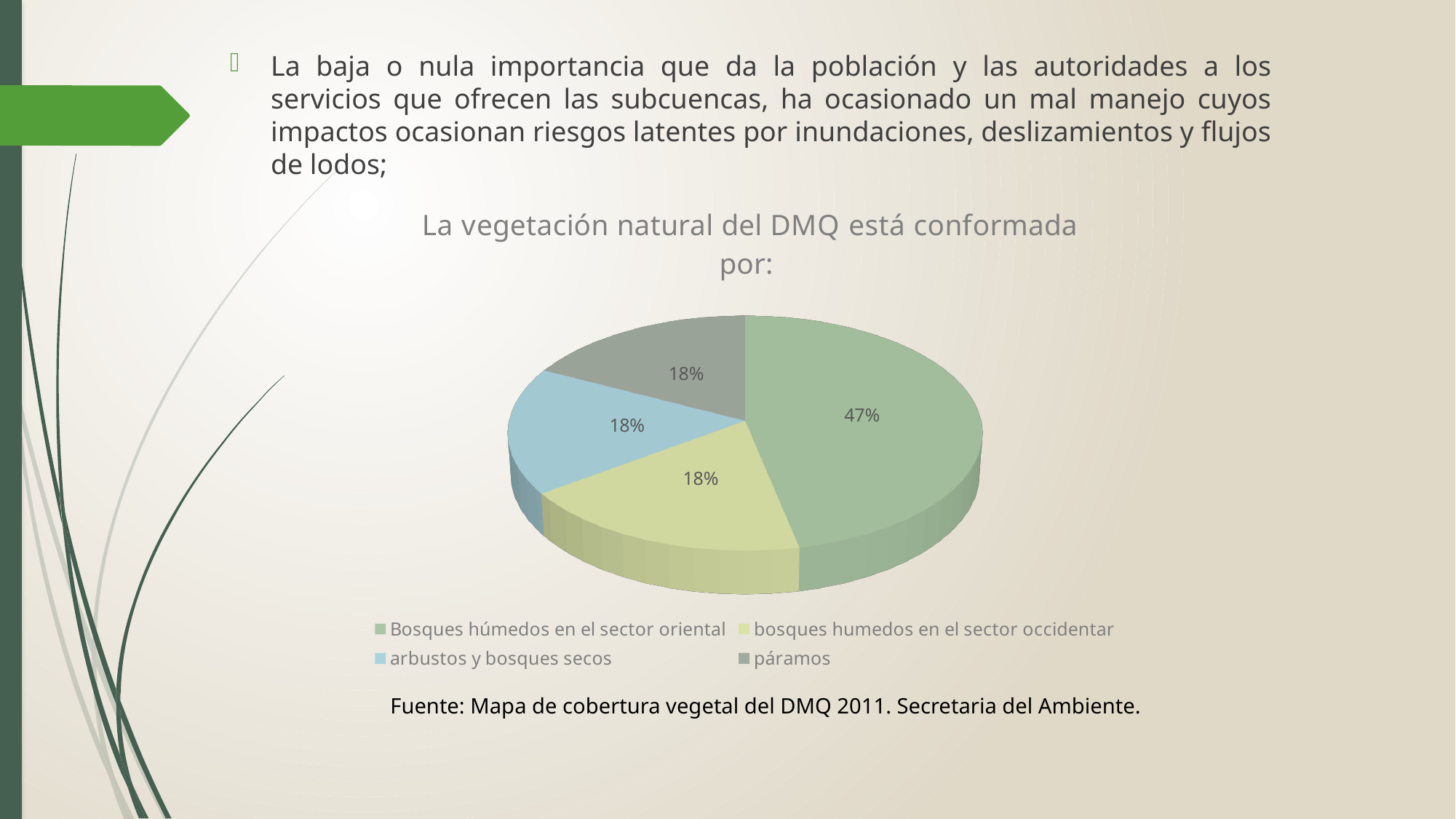
What percentage is shown for 'bosques humedos en el sector occidentar'? 18% Which category has the largest slice of the pie? Bosques húmedos en el sector oriental Which category is shown in blue in the pie chart? arbustos y bosques secos What type of chart is shown on the slide? Pie chart What percentage is shown for 'arbustos y bosques secos'? 18% What share of the pie does 'Bosques húmedos en el sector oriental' represent? 47% Which is larger: 'Bosques húmedos en el sector oriental' or 'arbustos y bosques secos'? Bosques húmedos en el sector oriental How many slices does the pie chart have? 4 How many percentage points larger is 'Bosques húmedos en el sector oriental' than 'páramos'? 29 What percentage is shown for 'páramos'? 18% How many categories does the legend list? 4 What is the title of the chart? La vegetación natural del DMQ está conformada por: